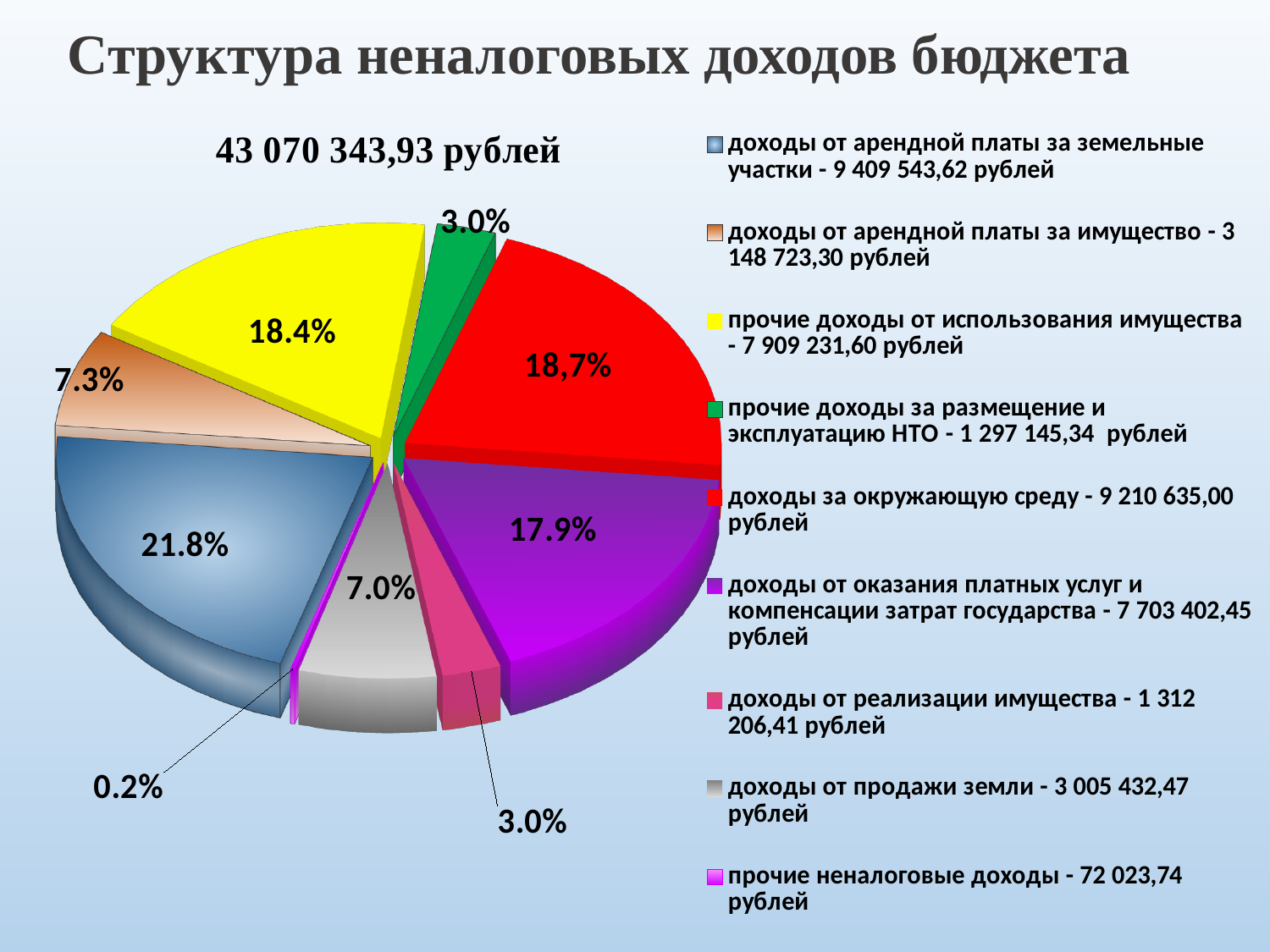
What share of the pie does 'доходы от арендной платы за земельные участки' take? 21.8% What share of the pie does 'доходы за окружающую среду' take? 18,7% Which category has the smallest share of the pie? прочие неналоговые доходы Which is larger: the share for 'доходы от арендной платы за имущество' or the share for 'доходы от продажи земли'? доходы от арендной платы за имущество How many categories does the legend list? 9 What is the value shown in the legend for 'доходы от оказания платных услуг и компенсации затрат государства'? 7 703 402,45 рублей What share of the pie does 'прочие неналоговые доходы' take? 0.2% What total amount is shown above the pie chart? 43 070 343,93 рублей What kind of chart is shown on the slide? pie chart Which category has the largest share of the pie? доходы от арендной платы за земельные участки